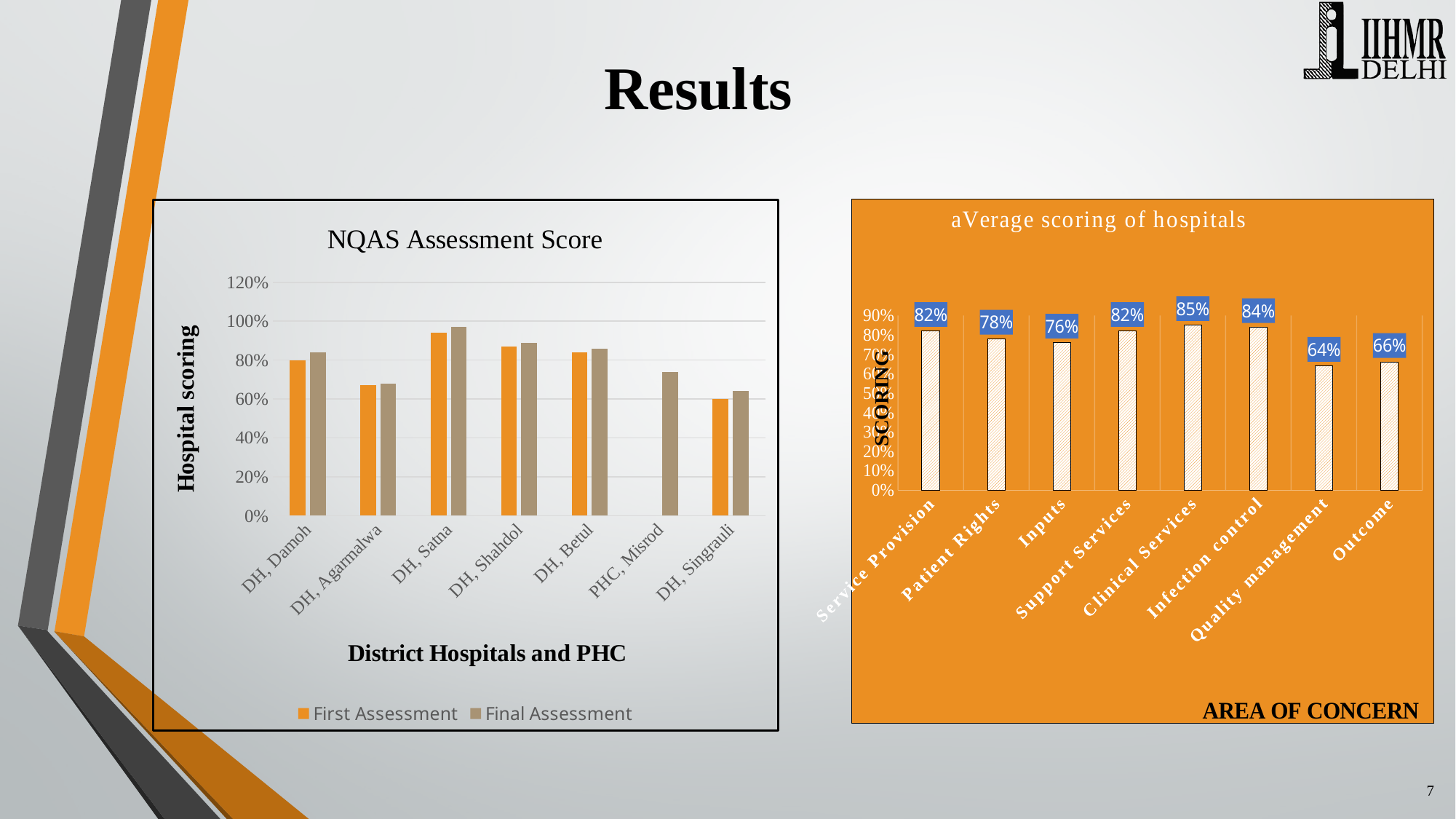
In the 'aVerage scoring of hospitals' chart, which area of concern has the highest score? Clinical Services How many areas of concern are shown in the 'aVerage scoring of hospitals' chart? 8 In the 'aVerage scoring of hospitals' chart, what is the value for Clinical Services? 85% In the 'aVerage scoring of hospitals' chart, which area of concern has the lowest score? Quality management In the 'aVerage scoring of hospitals' chart, what is the value for Quality management? 64% In the 'NQAS Assessment Score' chart, how many hospitals/PHCs are shown on the x axis? 7 In the 'NQAS Assessment Score' chart, is the First Assessment value for DH, Agarmalwa greater or less than 80%? less In the 'NQAS Assessment Score' chart, how many series does the legend list? 2 In the 'aVerage scoring of hospitals' chart, what is the difference between the scores for Infection control and Outcome? 18% In the 'NQAS Assessment Score' chart, which hospital has the highest Final Assessment score? DH, Satna In the 'aVerage scoring of hospitals' chart, which is larger, the score for Patient Rights or the score for Inputs? Patient Rights What kind of chart is the 'NQAS Assessment Score' chart? Bar chart